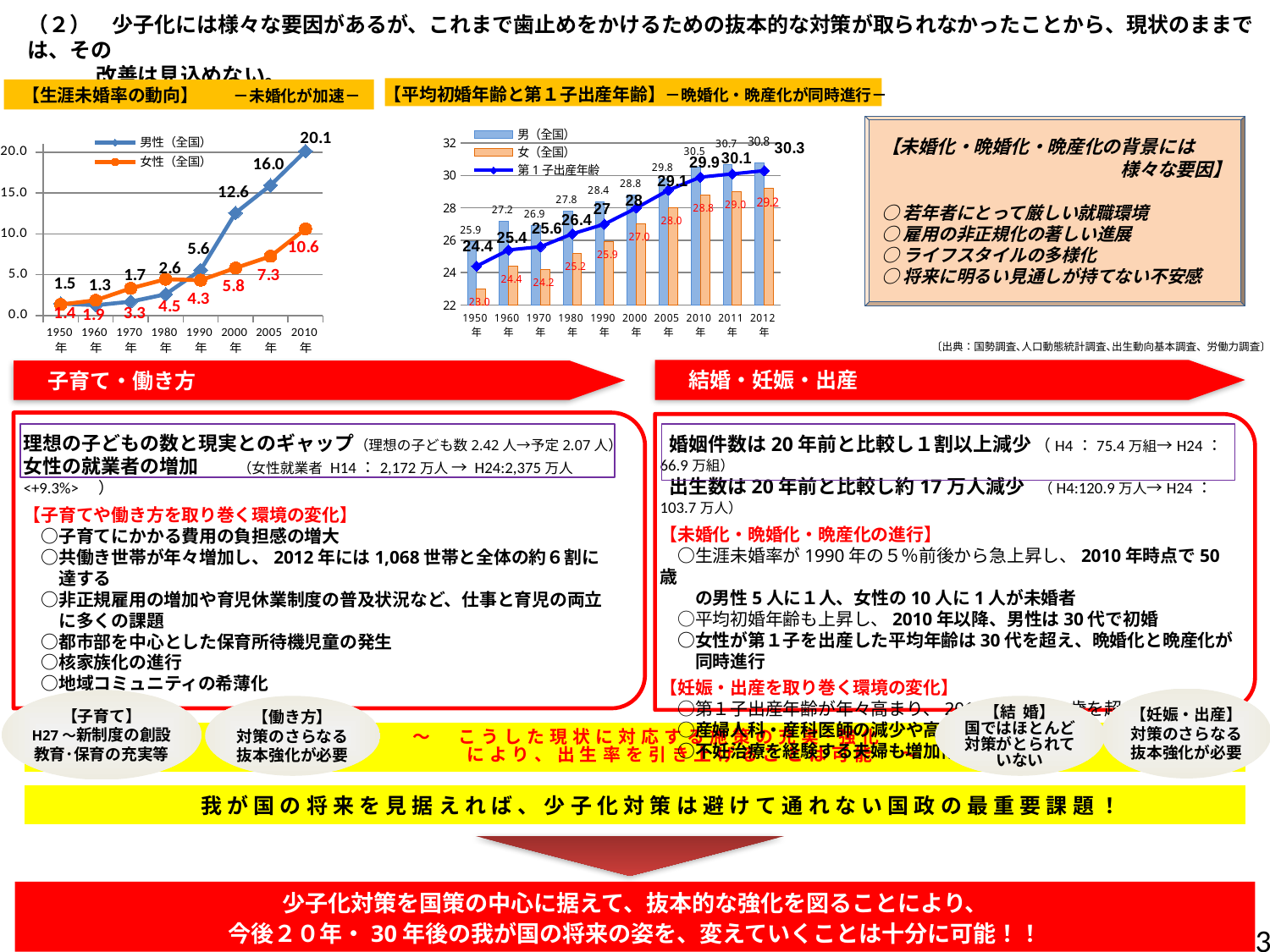
In the 【生涯未婚率の動向】 chart, what is the value for 女性（全国） in 2000年? 5.8 In the 【平均初婚年齢と第１子出産年齢】 chart, how many series does the legend list? 3 In the 【生涯未婚率の動向】 chart, how many series does the legend list? 2 In the 【平均初婚年齢と第１子出産年齢】 chart, what is the difference between the 男（全国） and 女（全国） values in 2012年? 1.6 In the 【生涯未婚率の動向】 chart, what is the difference between the 男性（全国） and 女性（全国） values in 2010年? 9.5 In the 【生涯未婚率の動向】 chart, in which year is the 男性（全国） value highest? 2010年 In the 【平均初婚年齢と第１子出産年齢】 chart, what is the 男（全国） value in 1950年? 25.9 In the 【生涯未婚率の動向】 chart, how many years are shown on the x axis? 8 In the 【平均初婚年齢と第１子出産年齢】 chart, what is the 第１子出産年齢 value in 2012年? 30.3 In the 【生涯未婚率の動向】 chart, does the 男性（全国） value rise or fall from 1980年 to 2010年? rise In the 【生涯未婚率の動向】 chart, what is the value for 男性（全国） in 2010年? 20.1 In the 【平均初婚年齢と第１子出産年齢】 chart, which is larger in 2000年, 男（全国） or 女（全国）? 男（全国）